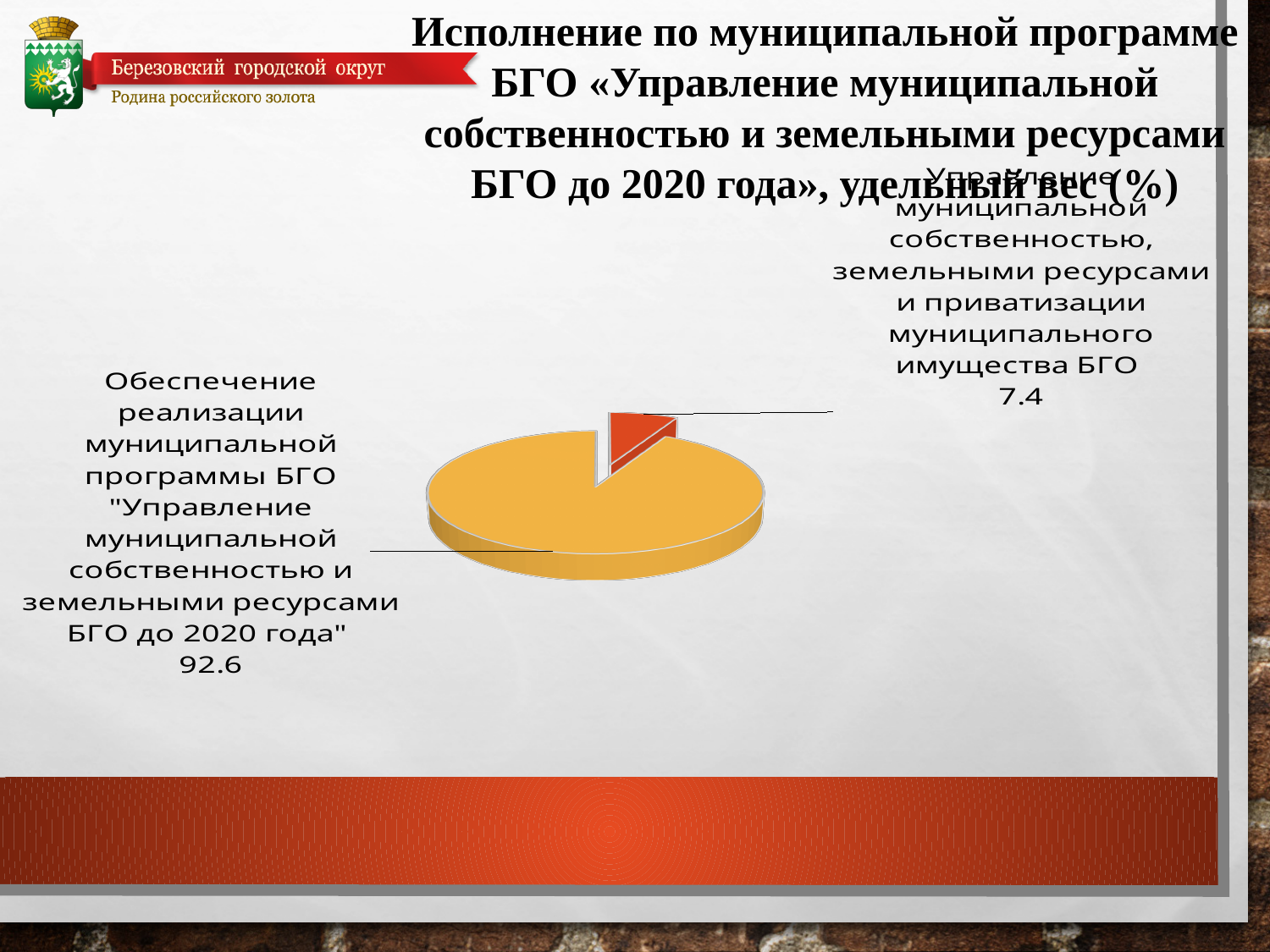
What is the difference between the values of the two slices (92.6 and 7.4)? 85.2 What colour is the smaller slice of the pie chart? red (orange-red) What is the value shown for the slice "Управление муниципальной собственностью, земельными ресурсами и приватизации муниципального имущества БГО"? 7.4 What share of the pie does the slice "Управление муниципальной собственностью, земельными ресурсами и приватизации муниципального имущества БГО" represent? 7.4% What kind of chart is shown on the slide? pie chart Which slice of the pie chart is the smallest? Управление муниципальной собственностью, земельными ресурсами и приватизации муниципального имущества БГО What unit is indicated in the chart title for the values shown? удельный вес (%) Which is larger: the slice for "Обеспечение реализации муниципальной программы..." or the slice for "Управление муниципальной собственностью, земельными ресурсами и приватизации..."? Обеспечение реализации муниципальной программы... How many slices does the pie chart have? 2 Which slice of the pie chart is the largest? Обеспечение реализации муниципальной программы БГО "Управление муниципальной собственностью и земельными ресурсами БГО до 2020 года" What is the value shown for the slice "Обеспечение реализации муниципальной программы БГО "Управление муниципальной собственностью и земельными ресурсами БГО до 2020 года""? 92.6 What share of the pie does the slice "Обеспечение реализации муниципальной программы БГО..." represent? 92.6%